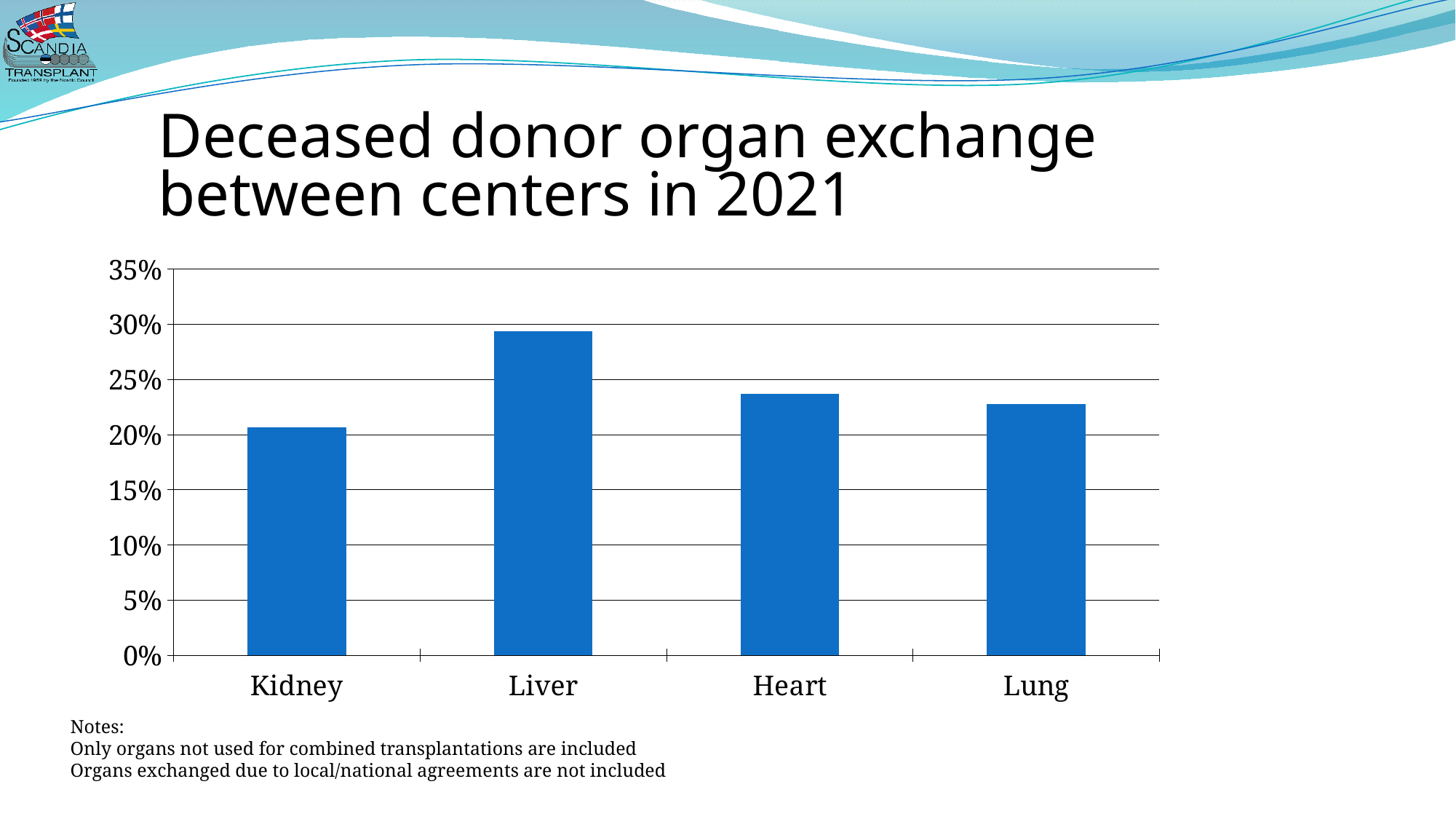
Is the value for Lung greater or less than 20%? greater Is the value for Heart greater or less than 25%? less Which is larger, the value for Liver or the value for Kidney? Liver Is the value for Kidney greater or less than 25%? less Which organ has the highest share of deceased donor organ exchange between centers in 2021? Liver Which is larger, the value for Liver or the value for Heart? Liver What is the title of the slide containing the chart? Deceased donor organ exchange between centers in 2021 Which organ has the lowest share of deceased donor organ exchange between centers in 2021? Kidney Which is larger, the value for Heart or the value for Kidney? Heart How many organ categories are shown on the x axis of the chart? 4 What kind of chart is shown on the slide? bar chart